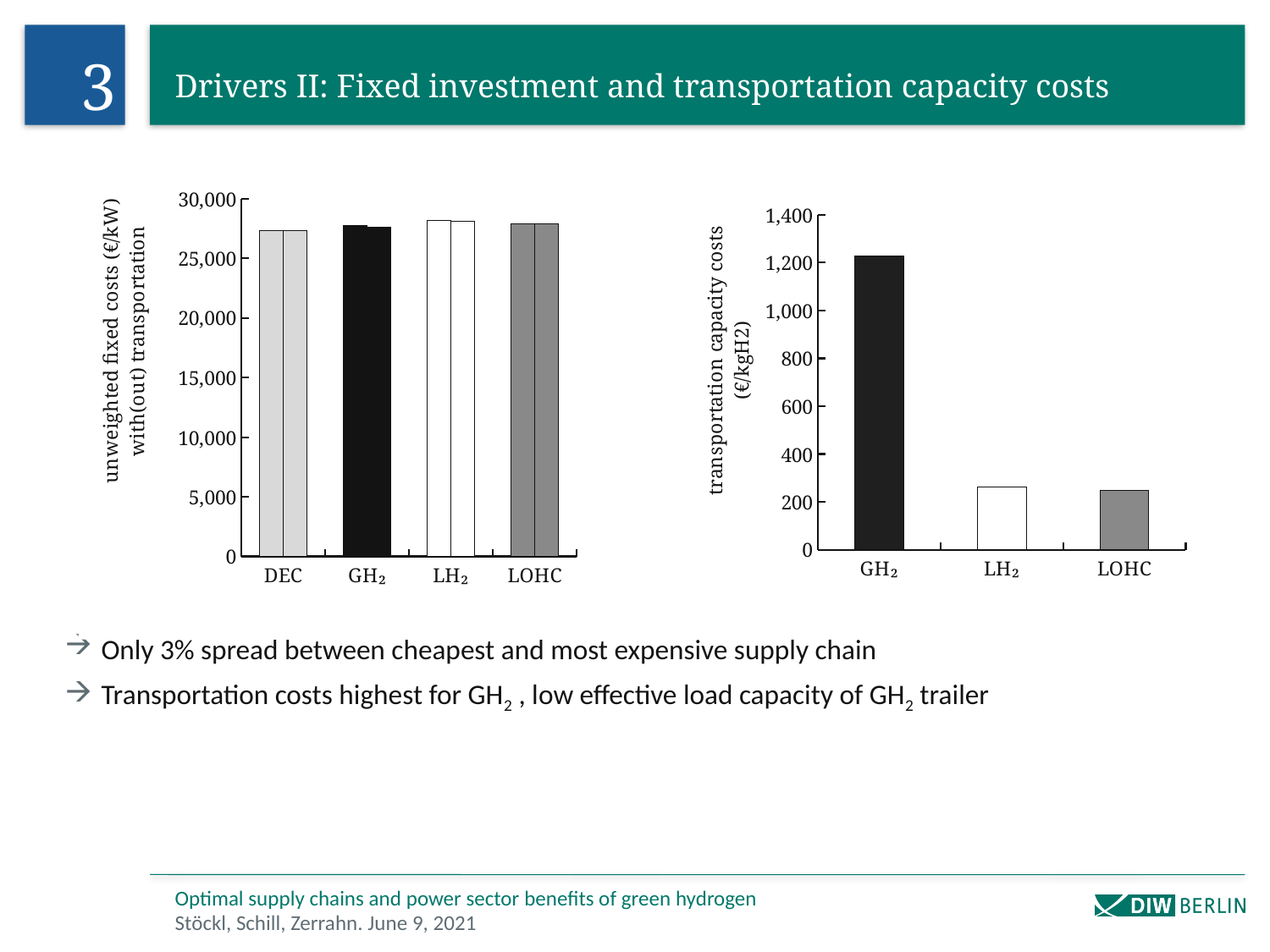
What kind of chart is the right chart on the slide? bar chart In the right chart, how many categories are shown on the x axis? 3 What unit is shown on the y axis of the right chart? €/kgH2 In the right chart, which is larger, the value for GH2 or the value for LOHC? GH2 In the left chart, how many categories are shown on the x axis? 4 In the right chart, is the value for GH2 greater or less than 1,000? greater In the right chart, which category has the highest transportation capacity cost? GH2 In the left chart, are the values for LH2 greater or less than 30,000? less In the right chart, is the value for LH2 greater or less than 400? less What kind of chart is the left chart on the slide? bar chart